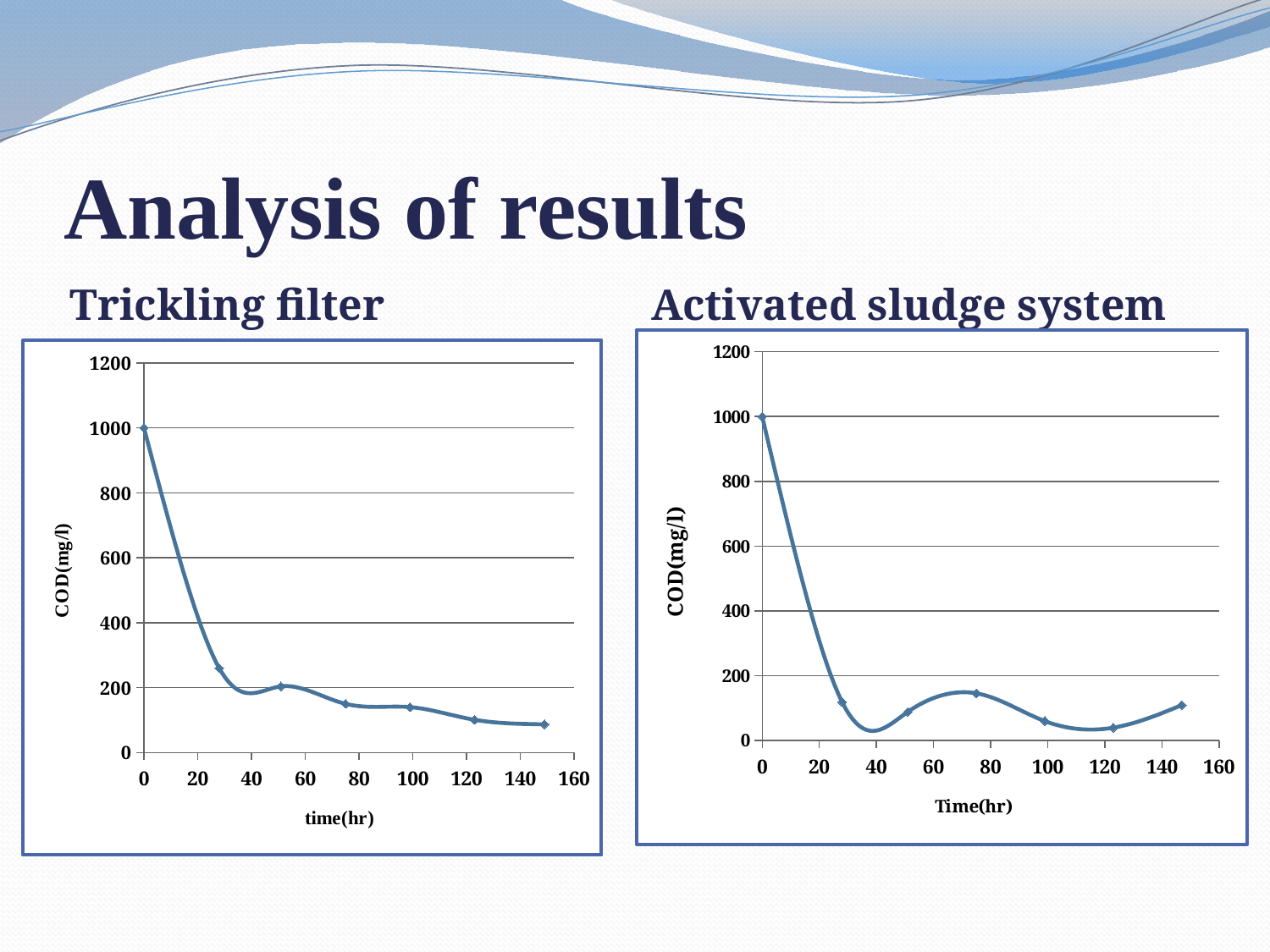
What is the y-axis label of the Activated sludge system chart? COD(mg/l) In the Trickling filter chart, what is the COD value at time 0 hr? 1000 What is the x-axis label of the Trickling filter chart? time(hr) In the Trickling filter chart, is the COD value at the second point (around 28 hr) greater or less than 200? greater In the Activated sludge system chart, is the COD value at the second point (around 28 hr) greater or less than 200? less In the Trickling filter chart, at which time is the COD value highest? 0 hr In the Trickling filter chart, is the COD value at the last point (around 148 hr) greater or less than 200? less What kind of chart is the Trickling filter chart? line chart In the Activated sludge system chart, what is the COD value at time 0 hr? 1000 In the Trickling filter chart, does the COD value overall rise or fall as time increases? fall How many data points are plotted in the Trickling filter chart? 7